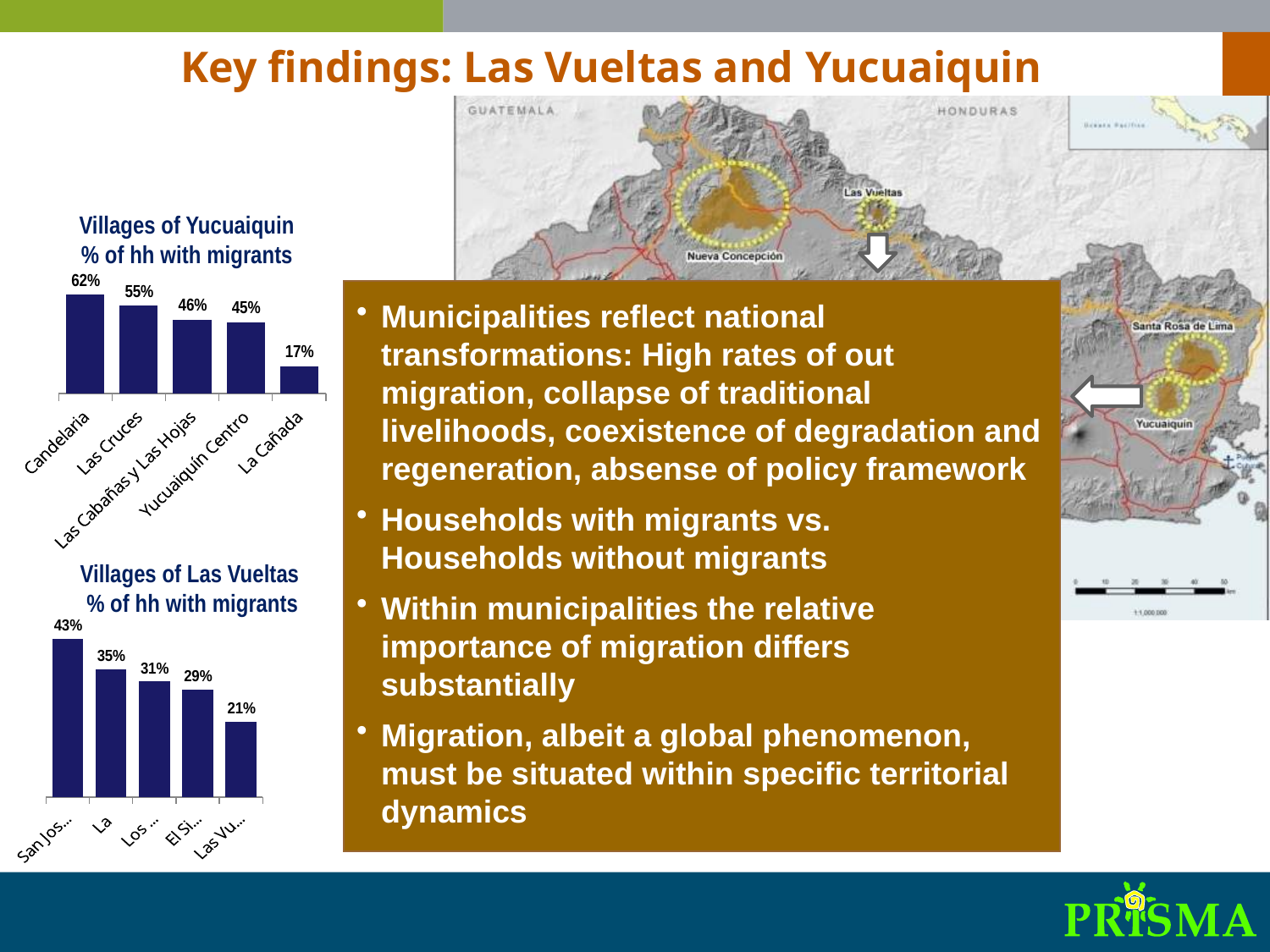
In the 'Villages of Yucuaiquin' chart, what is the value for Las Cruces? 55% In the 'Villages of Las Vueltas' chart, what is the highest value shown? 43% In the 'Villages of Las Vueltas' chart, do the values rise or fall from left to right? Fall How many villages are shown in the 'Villages of Yucuaiquin' chart? 5 In the 'Villages of Yucuaiquin' chart, what is the difference between Candelaria and La Cañada? 45% What type of chart is the 'Villages of Las Vueltas' chart? Bar chart In the 'Villages of Las Vueltas' chart, what is the lowest value shown? 21% In the 'Villages of Yucuaiquin' chart, what is the % of hh with migrants for Candelaria? 62% In the 'Villages of Yucuaiquin' chart, which village has the lowest % of hh with migrants? La Cañada In the 'Villages of Yucuaiquin' chart, what is the value for La Cañada? 17% In the 'Villages of Yucuaiquin' chart, which village has the highest % of hh with migrants? Candelaria In the 'Villages of Yucuaiquin' chart, which is larger: Las Cabañas y Las Hojas or Yucuaiquín Centro? Las Cabañas y Las Hojas